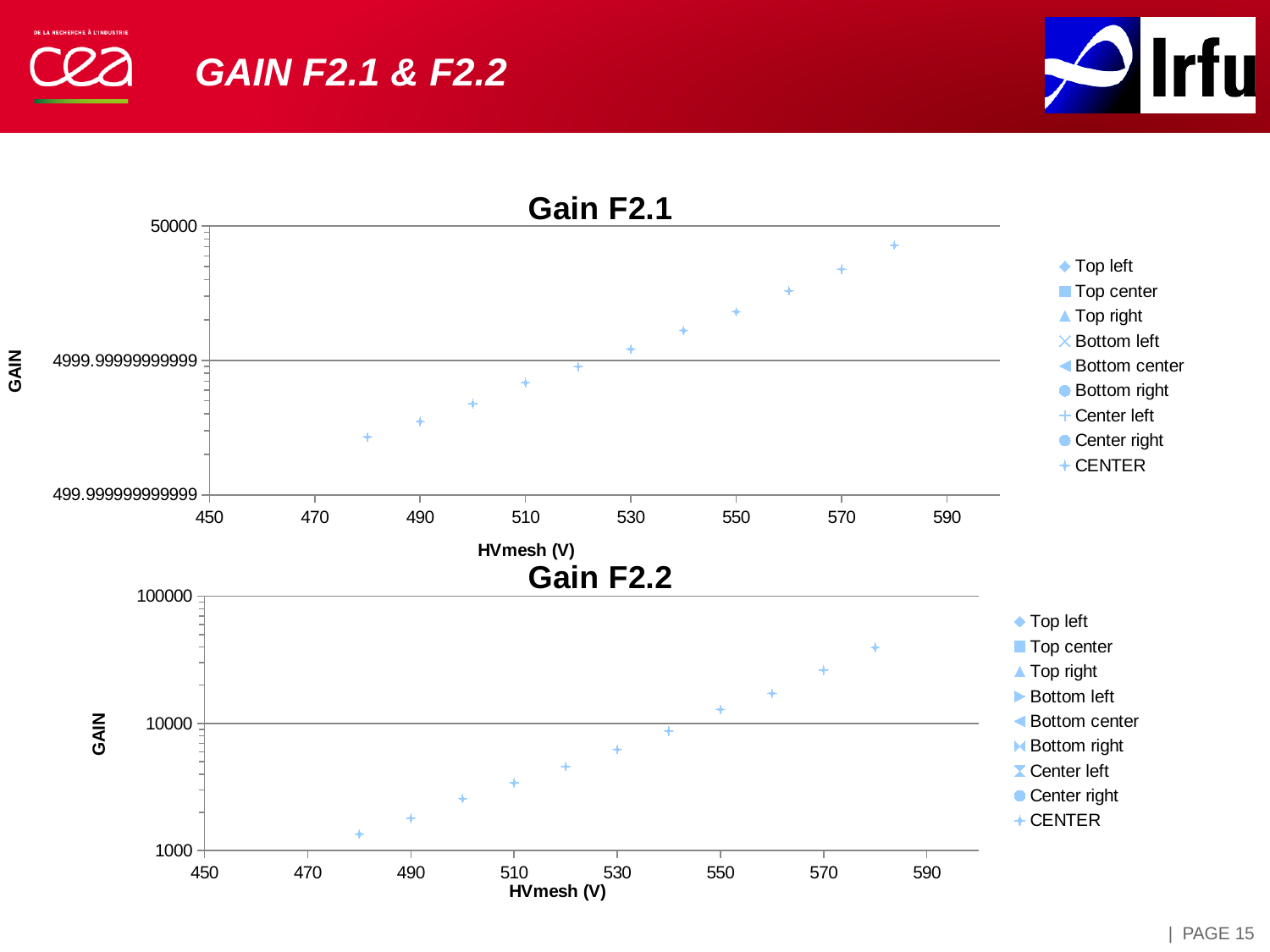
What kind of chart is the Gain F2.1 chart? scatter chart In the Gain F2.2 chart, is the value at HVmesh 530 V greater or less than 10000? less In the Gain F2.1 chart, do the plotted values rise or fall as HVmesh increases? rise What is the x-axis label of the Gain F2.1 chart? HVmesh (V) How many data points are plotted in the Gain F2.2 chart? 11 In the Gain F2.1 chart, at which HVmesh value is the plotted gain lowest? 480 In the Gain F2.2 chart, which has the larger gain: HVmesh 490 V or HVmesh 560 V? 560 V In the Gain F2.2 chart, is the value at HVmesh 550 V greater or less than 10000? greater In the Gain F2.1 chart, is the value at HVmesh 510 V greater or less than 5000? less How many series does the legend of the Gain F2.2 chart list? 9 In the Gain F2.2 chart, at which HVmesh value is the plotted gain highest? 580